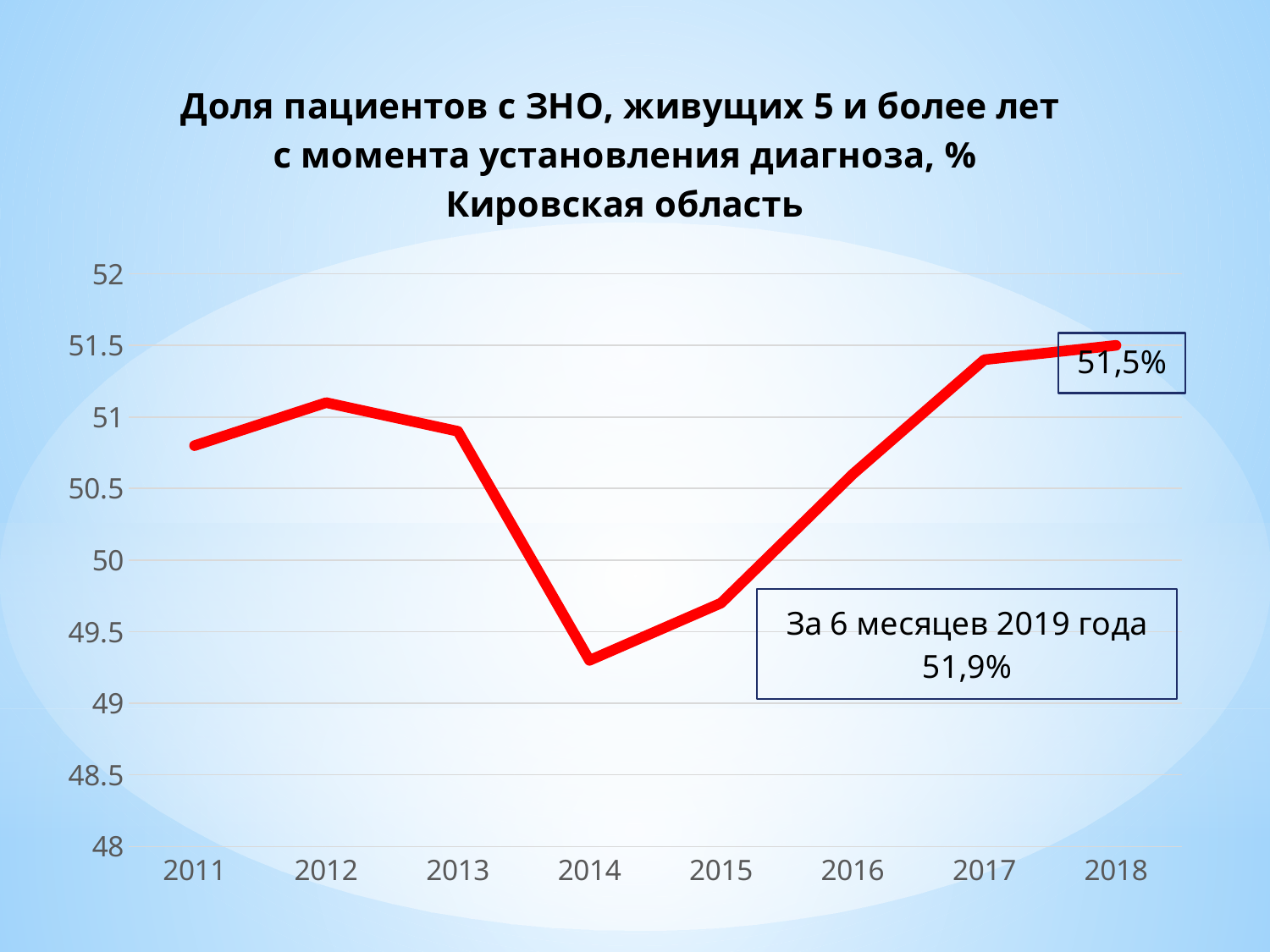
What kind of chart is shown on the slide? line chart How many years are plotted along the x axis? 8 Do the values rise or fall from 2012 to 2014? fall Which is larger, the value for 2012 or the value for 2014? 2012 Do the values rise or fall from 2014 to 2018? rise Which region is named in the chart title? Кировская область Which year has the lowest value? 2014 Is the value for 2011 greater or less than 50.5? greater Is the value for 2017 greater or less than 51? greater Is the value for 2014 greater or less than 49.5? less What is the value for 2018? 51,5%